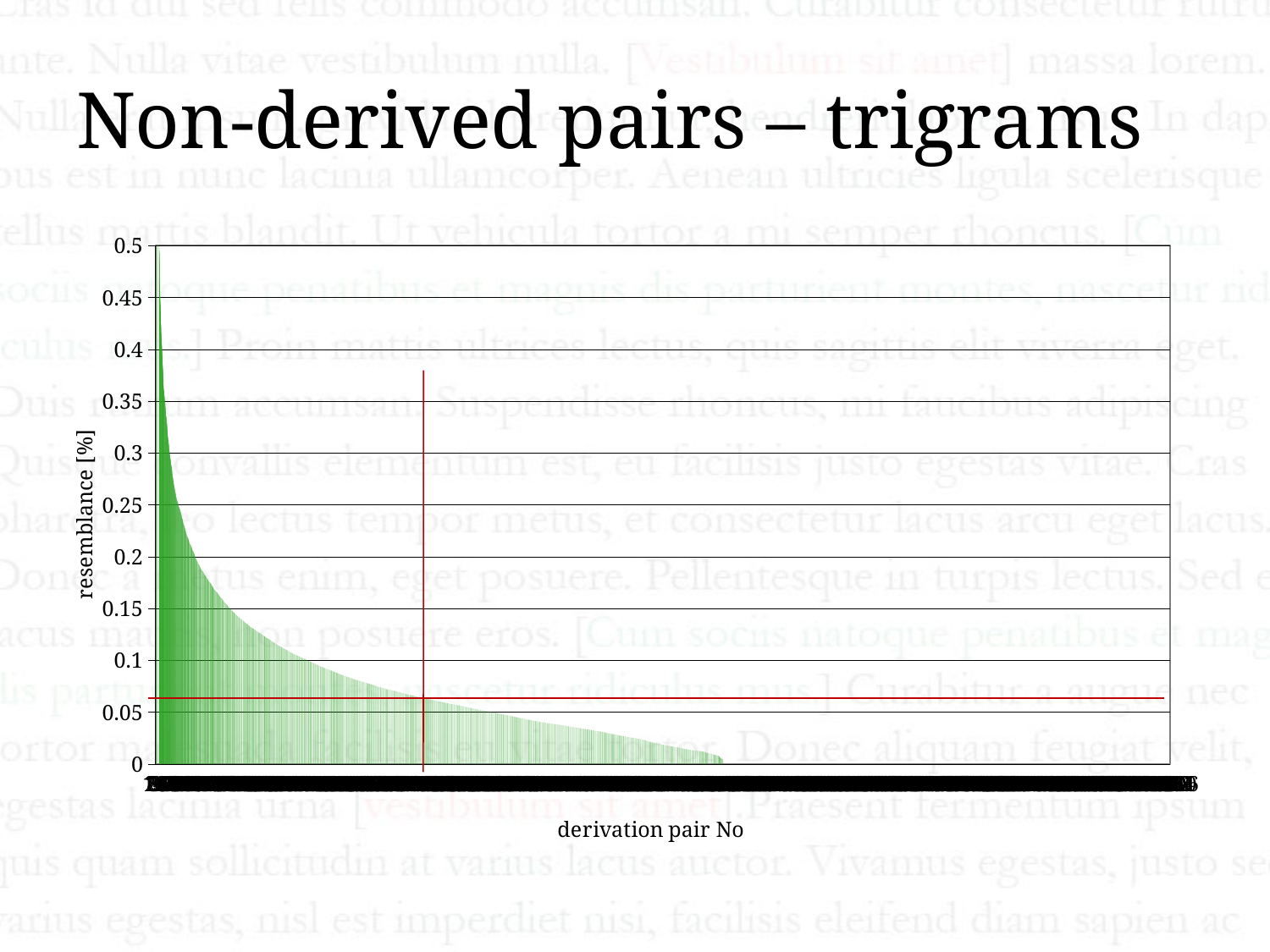
Is the value of the bar at the position of the vertical red line greater or less than 0.1? less Is the highest plotted value greater or less than 0.4? greater What kind of chart is shown on the slide? bar chart What is the label of the vertical axis of the chart? resemblance [%] Are the values at the right-hand end of the chart greater or less than 0.05? less Do the plotted values rise or fall from left to right along the x axis? fall What is the highest tick value shown on the vertical axis? 0.5 What is the title of the chart on the slide? Non-derived pairs – trigrams